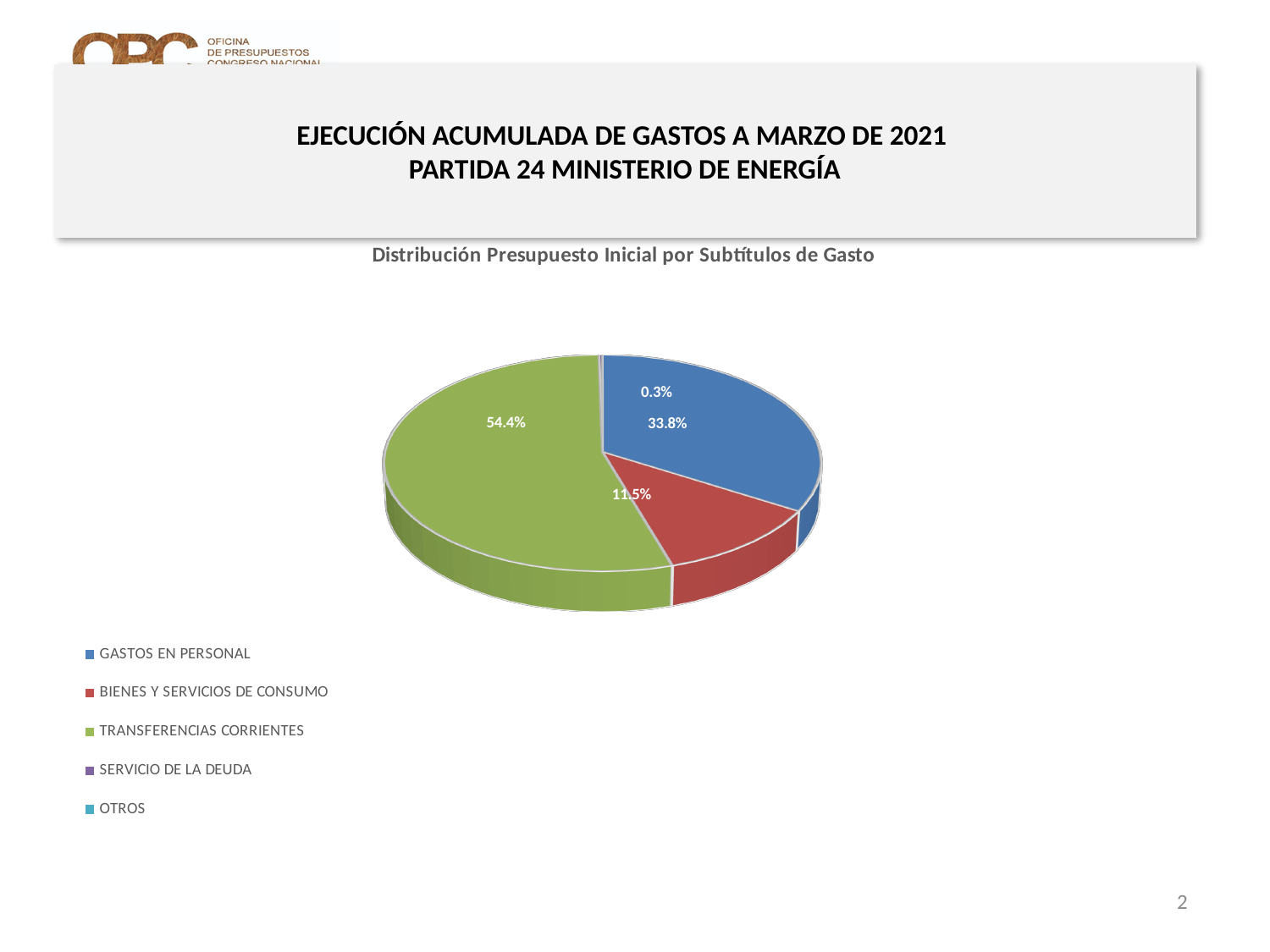
What colour is the TRANSFERENCIAS CORRIENTES slice? Green What percentage of the pie does BIENES Y SERVICIOS DE CONSUMO represent? 11.5% What percentage of the pie does TRANSFERENCIAS CORRIENTES represent? 54.4% How many categories does the chart legend list? 5 How many percentage points larger is the GASTOS EN PERSONAL slice than the BIENES Y SERVICIOS DE CONSUMO slice? 22.3 percentage points How many percentage points larger is the TRANSFERENCIAS CORRIENTES slice than the GASTOS EN PERSONAL slice? 20.6 percentage points What is the title of the chart? Distribución Presupuesto Inicial por Subtítulos de Gasto Which is larger, the share for GASTOS EN PERSONAL or the share for BIENES Y SERVICIOS DE CONSUMO? GASTOS EN PERSONAL Which category has the largest slice of the pie? TRANSFERENCIAS CORRIENTES What is the smallest percentage value labeled on the pie chart? 0.3% What kind of chart is shown on the slide? Pie chart What percentage of the pie does GASTOS EN PERSONAL represent? 33.8%